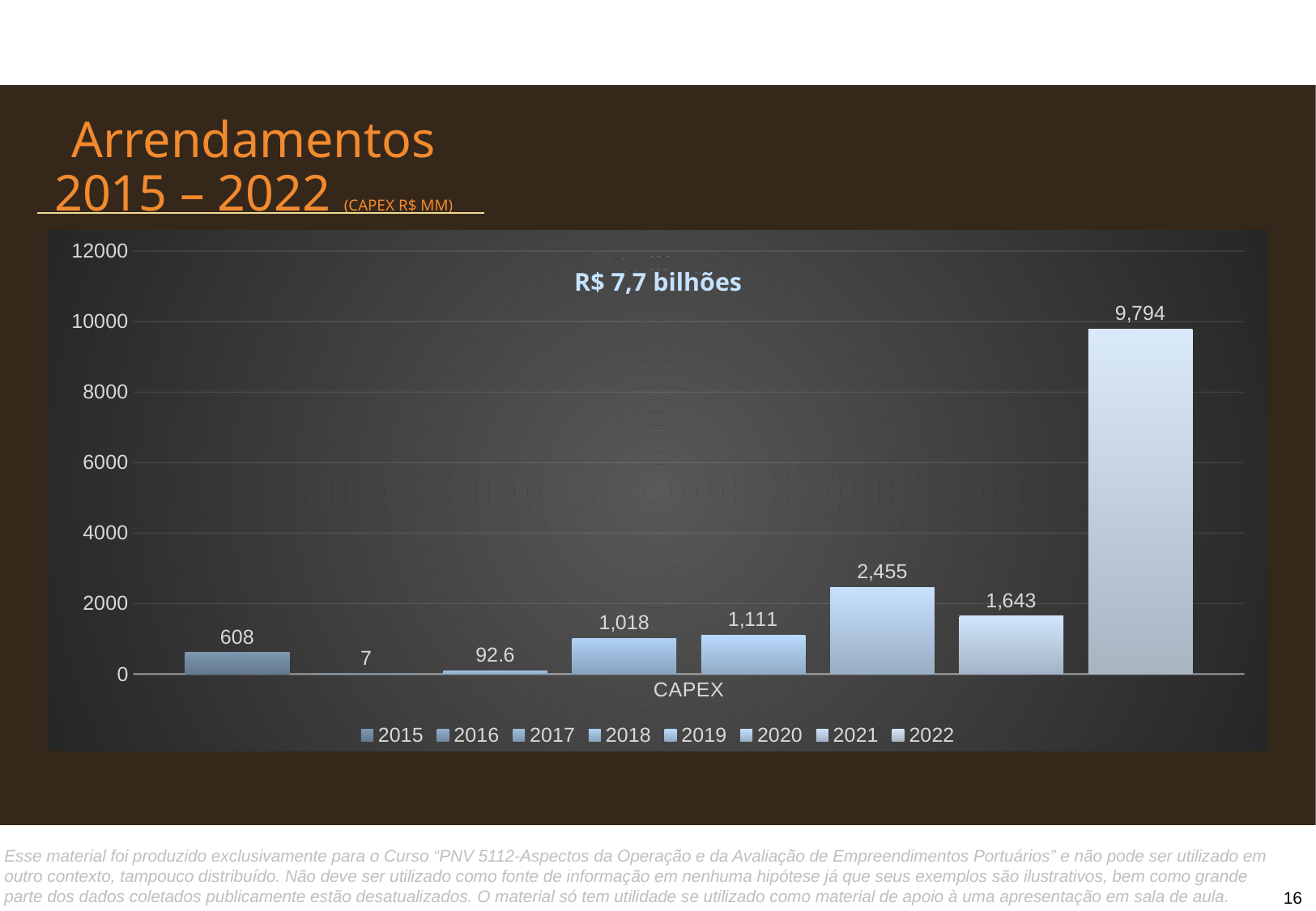
What is the difference between the CAPEX values for 2019 and 2018? 93 Which is larger, the CAPEX value for 2018 or for 2019? 2019 What is the CAPEX value for 2022? 9,794 What is the CAPEX value for 2017? 92.6 What total amount is written in the text box inside the chart? R$ 7,7 bilhões Which year has the highest CAPEX value? 2022 What is the CAPEX value for 2020? 2,455 What is the difference between the CAPEX values for 2020 and 2021? 812 What kind of chart is shown on the slide? bar chart Which year has the lowest CAPEX value? 2016 How many series does the legend list? 8 Is the CAPEX value for 2022 greater or less than 8000? greater